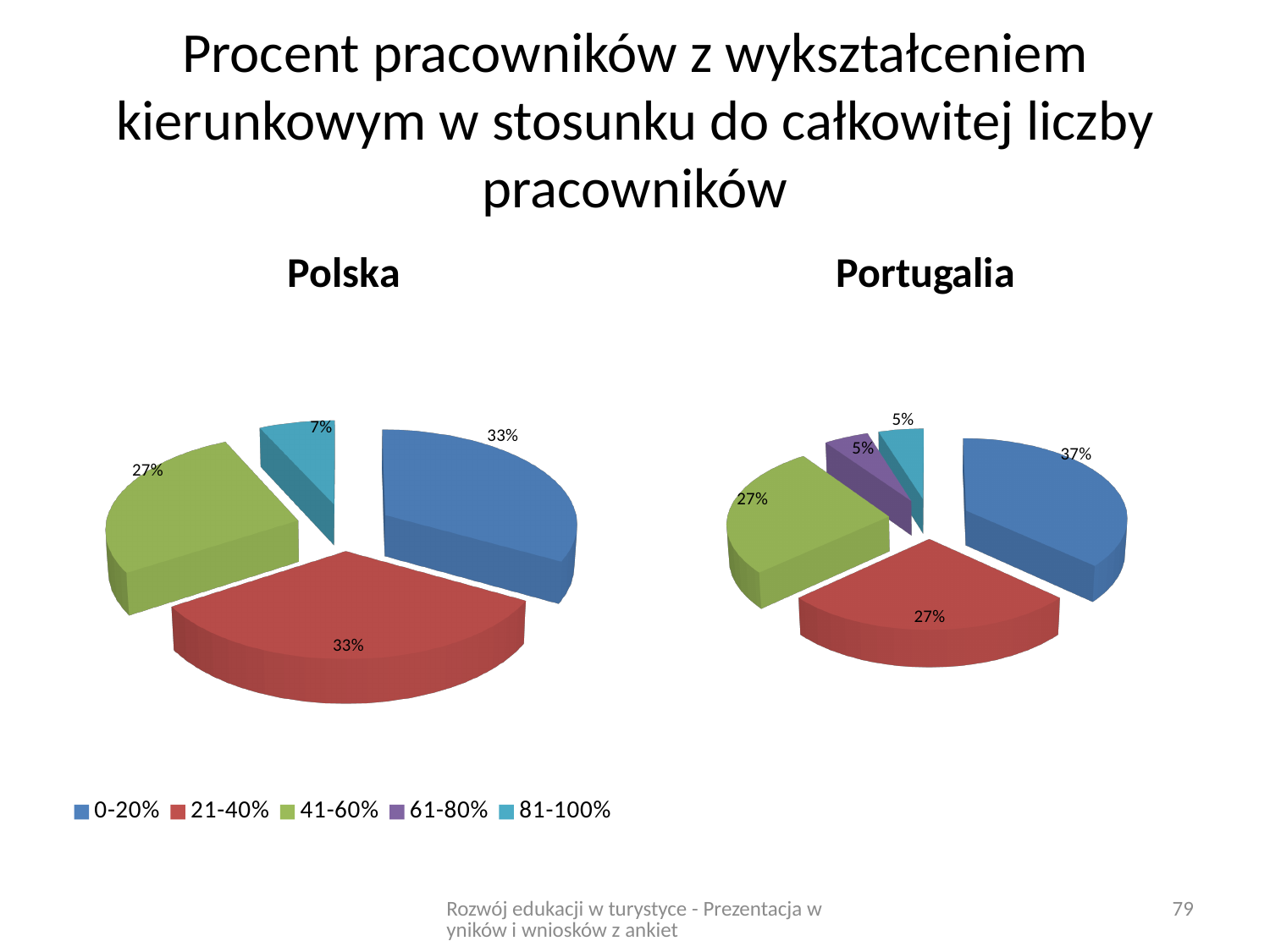
In the Polska chart, which category has the smallest slice? 81-100% Which is larger: the 21-40% slice in the Polska chart or the 21-40% slice in the Portugalia chart? Polska In the Portugalia chart, what share of the pie is the 61-80% category? 5% In the Portugalia chart, what is the difference between the 0-20% slice and the 21-40% slice? 10 percentage points In the Portugalia chart, what share of the pie is the 0-20% category? 37% What type of chart is used for Polska and Portugalia on this slide? Pie chart In the Polska chart, what share of the pie is the 0-20% category? 33% In the Polska chart, what share of the pie is the 41-60% category? 27% How many categories does the legend list? 5 How many slices does the Portugalia pie chart have? 5 In the Polska chart, what share of the pie is the 81-100% category? 7% In the Portugalia chart, which category has the largest slice? 0-20%